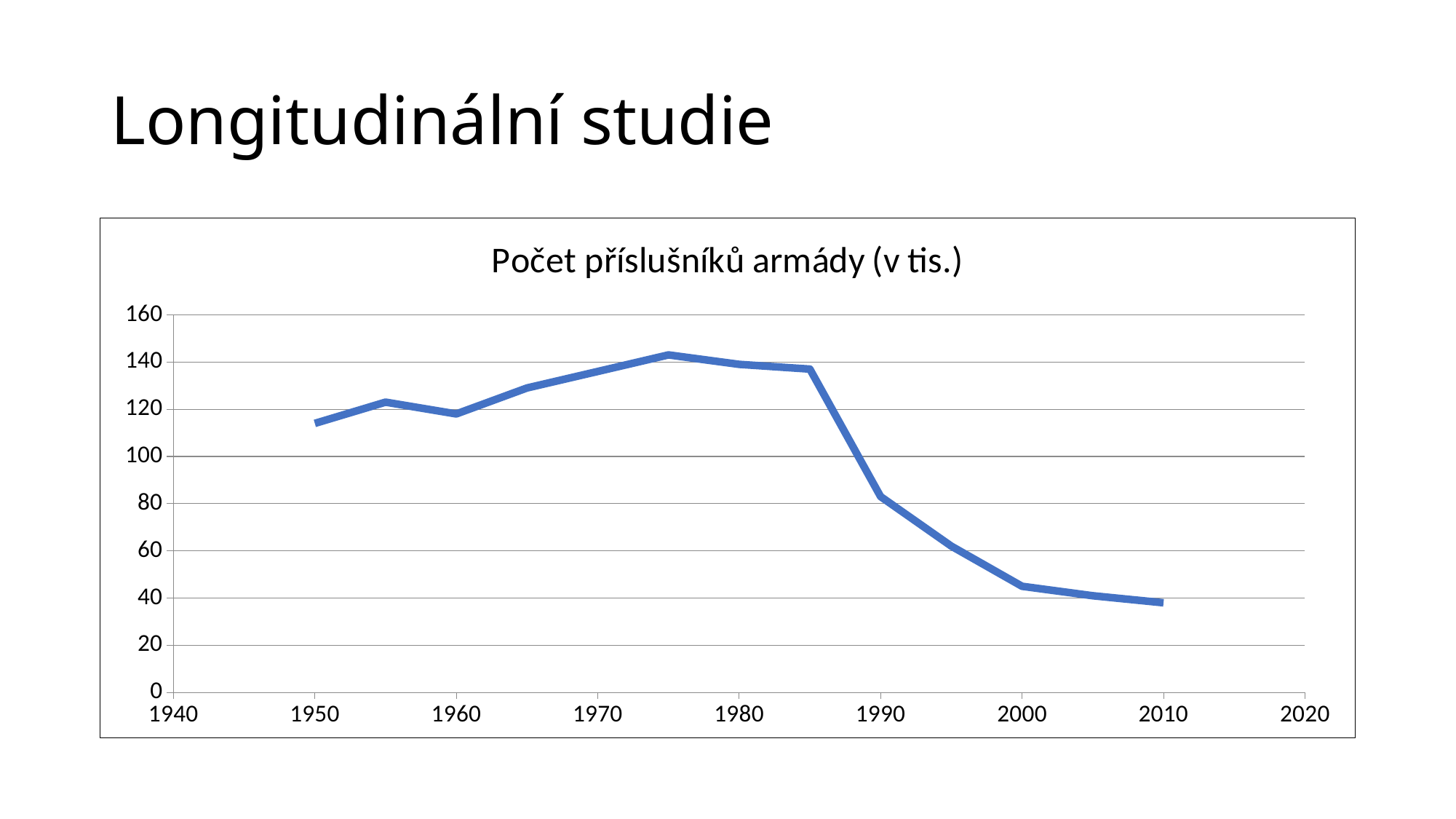
Is the value for 1975 greater or less than 140? greater In which year does the line reach its lowest value? 2010 What kind of chart is shown on the slide? line chart What is the title of the chart? Počet příslušníků armády (v tis.) Which year has the larger value, 1960 or 1970? 1970 In which year does the line reach its highest value? 1975 Which year has the larger value, 1950 or 1990? 1950 Is the value for 1990 greater or less than 100? less Is the value for 2000 greater or less than 60? less Does the line rise or fall between 1985 and 2010? fall